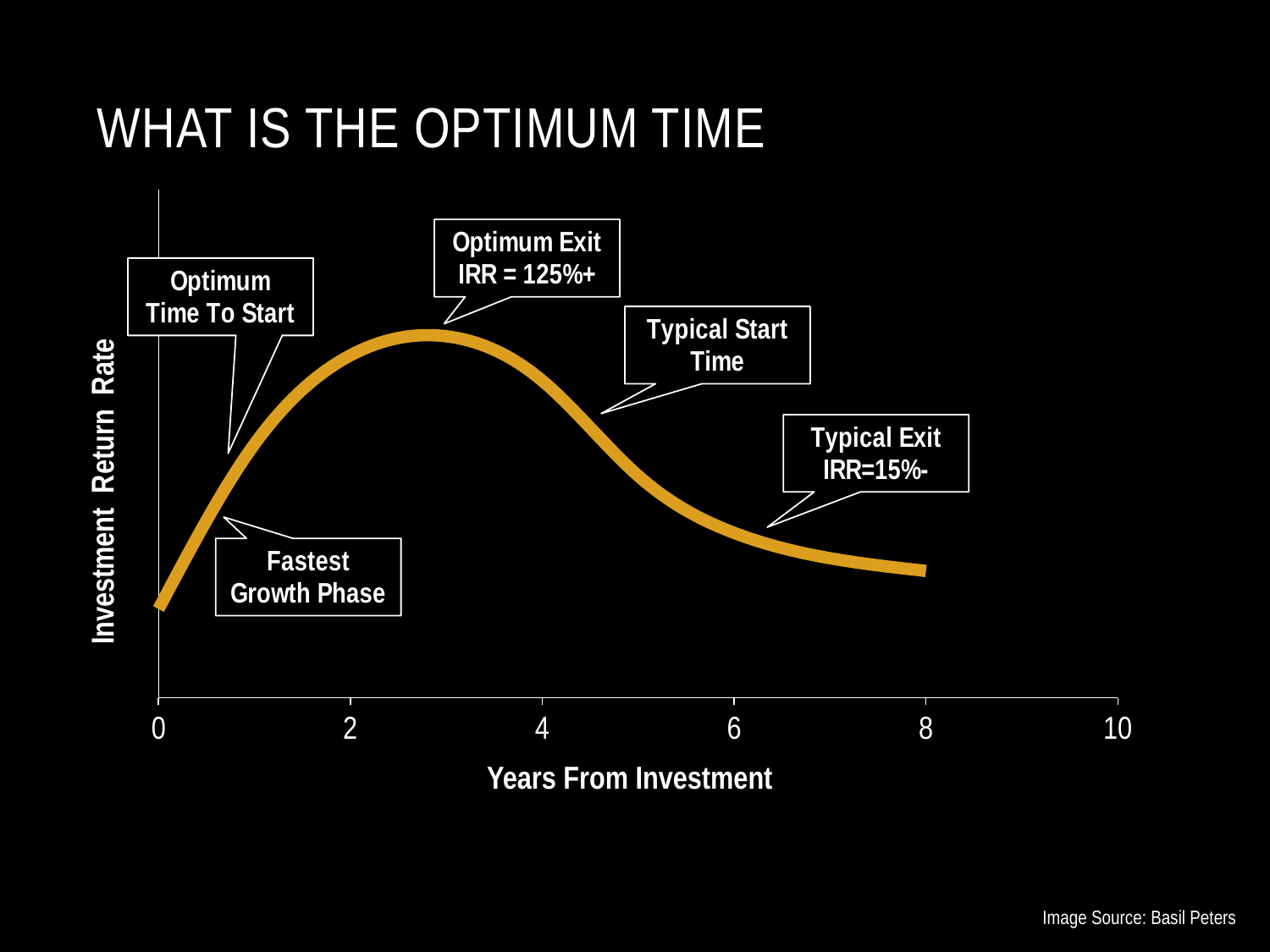
What IRR is given in the 'Typical Exit' callout? 15%- Which callout is placed at the peak of the curve? Optimum Exit IRR = 125%+ What is the label of the x axis? Years From Investment What is the highest tick value shown on the x axis? 10 Is the peak of the curve located before or after year 4 on the x axis? before Which is higher on the curve: the investment return rate at year 2 or at year 8? year 2 Does the curve rise or fall between year 0 and year 2? rise What is the label of the y axis? Investment Return Rate What kind of chart is shown on the slide? line chart Does the curve rise or fall between year 4 and year 8? fall How many callout labels annotate the curve? 5 What IRR is given in the 'Optimum Exit' callout? 125%+